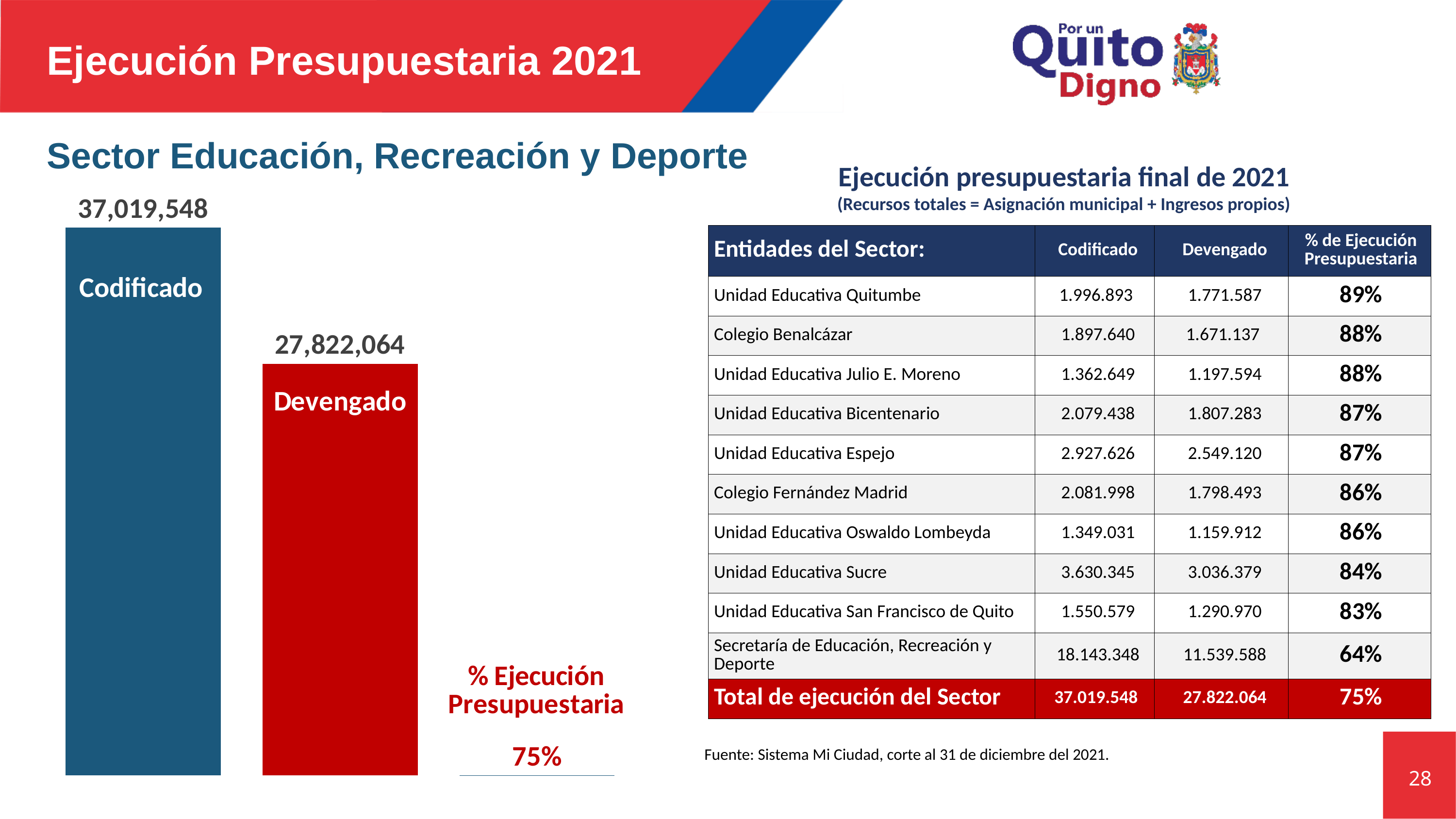
In the bar chart, what is the difference between the Codificado and Devengado values? 9,197,484 What percentage is shown next to the bar chart as the % Ejecución Presupuestaria? 75% In the bar chart, what is the value of the Devengado bar? 27,822,064 What kind of chart is shown on the left of the slide? Bar chart In the bar chart, what colour is the Codificado bar? Blue In the bar chart, which bar is the lowest? Devengado In the bar chart, what is the value of the Codificado bar? 37,019,548 In the bar chart, which is larger, Codificado or Devengado? Codificado How many bars are shown in the bar chart? 2 In the bar chart, what colour is the Devengado bar? Red In the bar chart, which bar is the highest? Codificado